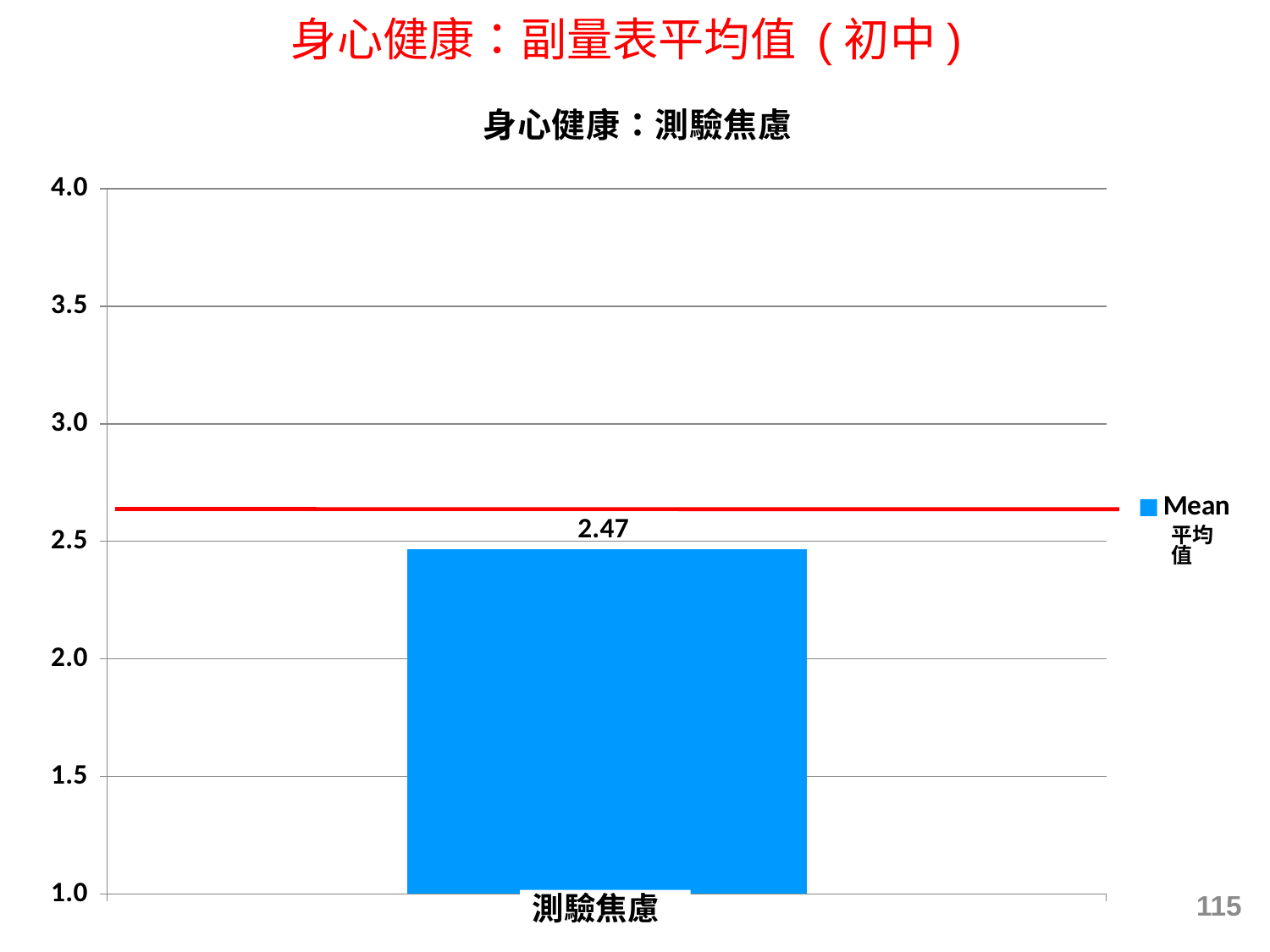
What is the value of the bar for 測驗焦慮? 2.47 What is the category label on the horizontal axis? 測驗焦慮 What series name does the legend show? Mean 平均值 Is the value for 測驗焦慮 greater or less than 2.5? less What is the highest value shown on the vertical axis? 4.0 Is the value for 測驗焦慮 greater or less than 2.0? greater How many bars are plotted in the chart? 1 What is the title of the chart? 身心健康：測驗焦慮 What is the lowest value shown on the vertical axis? 1.0 What kind of chart is shown on the slide? bar chart How many series does the legend list? 1